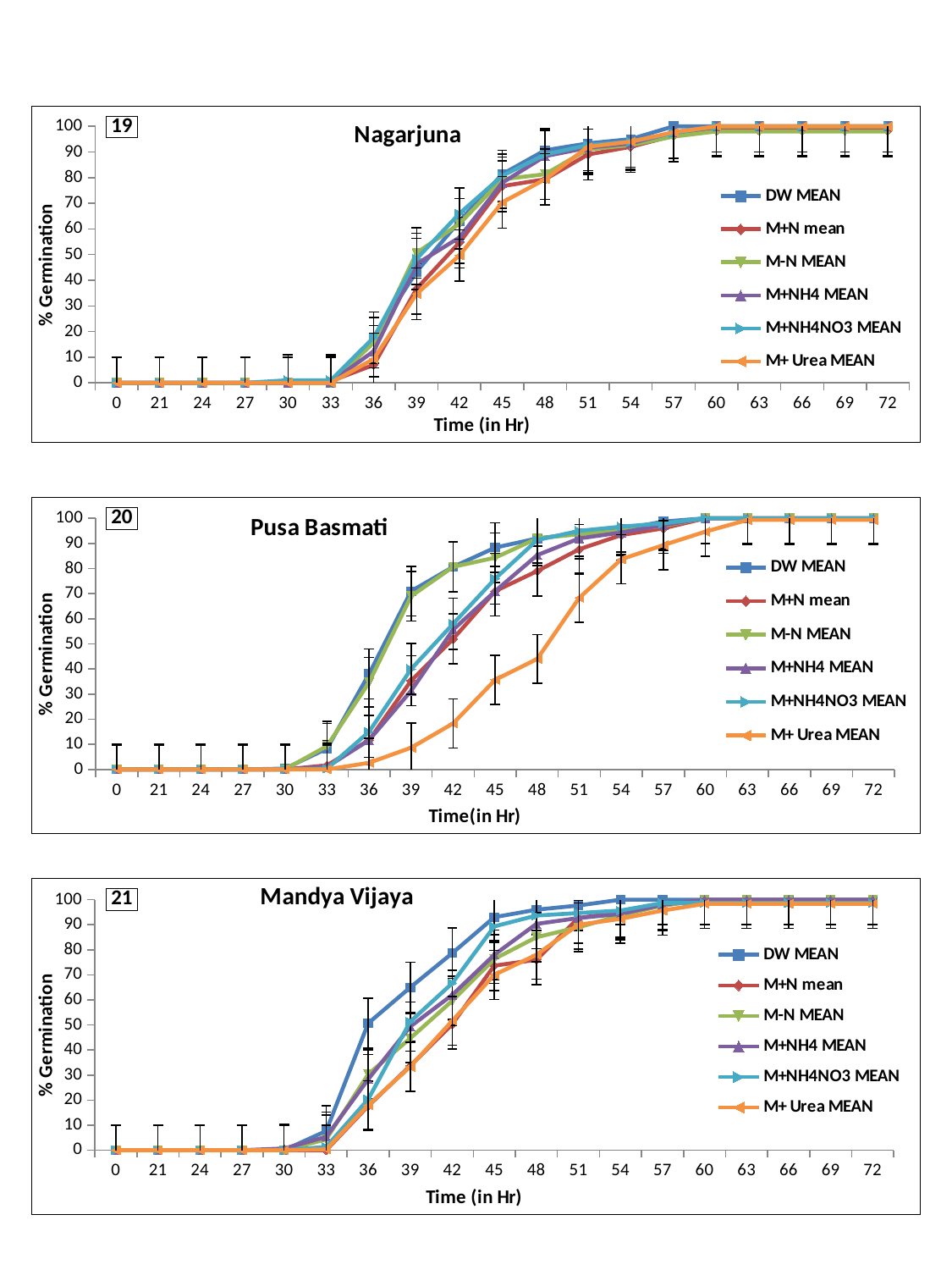
In the Mandya Vijaya chart, is the value for DW MEAN at 42 hr greater or less than 70? greater How many series does the legend of the Pusa Basmati chart list? 6 In the Pusa Basmati chart, is the value for M+ Urea MEAN at 51 hr greater or less than 60? greater In the Nagarjuna chart, do the DW MEAN values rise or fall as time increases from 33 hr to 57 hr? rise In the Pusa Basmati chart, is the value for M+ Urea MEAN at 45 hr greater or less than 50? less How many time points are marked on the x axis of the Mandya Vijaya chart? 19 In the Mandya Vijaya chart, which series has the highest value at 39 hr? DW MEAN What kind of chart is the Nagarjuna chart? line chart In the Pusa Basmati chart, which is larger at 48 hr: DW MEAN or M+ Urea MEAN? DW MEAN What is the x-axis label of the Nagarjuna chart? Time (in Hr) What is the y-axis label of the Mandya Vijaya chart? % Germination